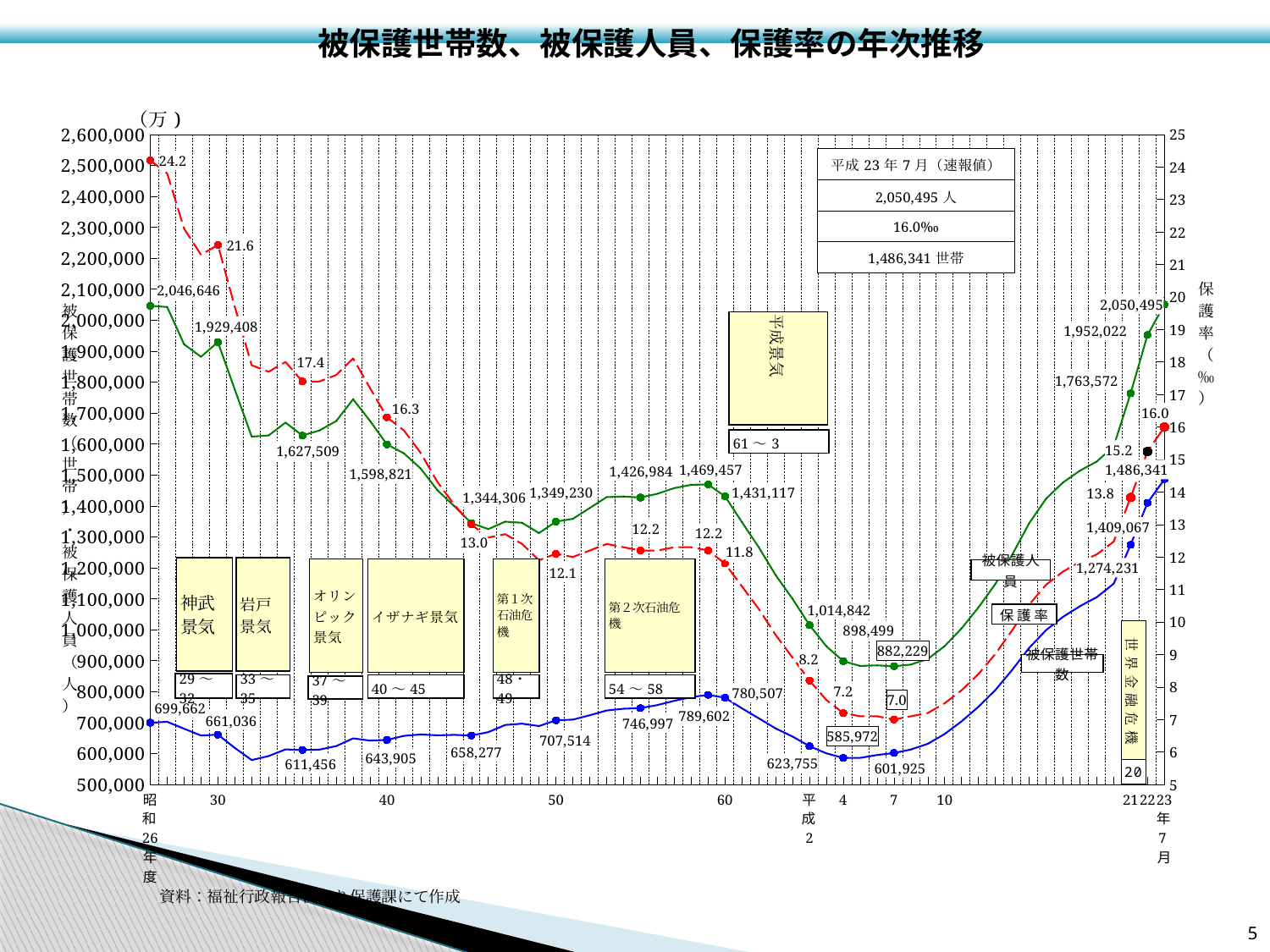
Which is larger, the 被保護人員 label 1,426,984 or 1,469,457? 1,469,457 What kind of chart is shown on the slide? line chart What is the 保護率 value labelled at the start of the series in 昭和26年度? 24.2 What is the title of the chart? 被保護世帯数、被保護人員、保護率の年次推移 What is the difference between the 被保護人員 labels 2,050,495 and 1,952,022? 98,473 How many data series are plotted on the chart? 3 What is the lowest labelled value of the 被保護世帯数 series? 585,972 What is the lowest labelled value of the 保護率 series? 7.0 What is the number of 被保護世帯数 for 平成23年7月 (速報値) shown in the box? 1,486,341 世帯 What is the value of 被保護人員 for 平成23年7月 (速報値) shown in the box? 2,050,495 人 What is the 保護率 for 平成23年7月 (速報値) shown in the box? 16.0‰ What is the highest labelled value of the 被保護人員 series? 2,050,495